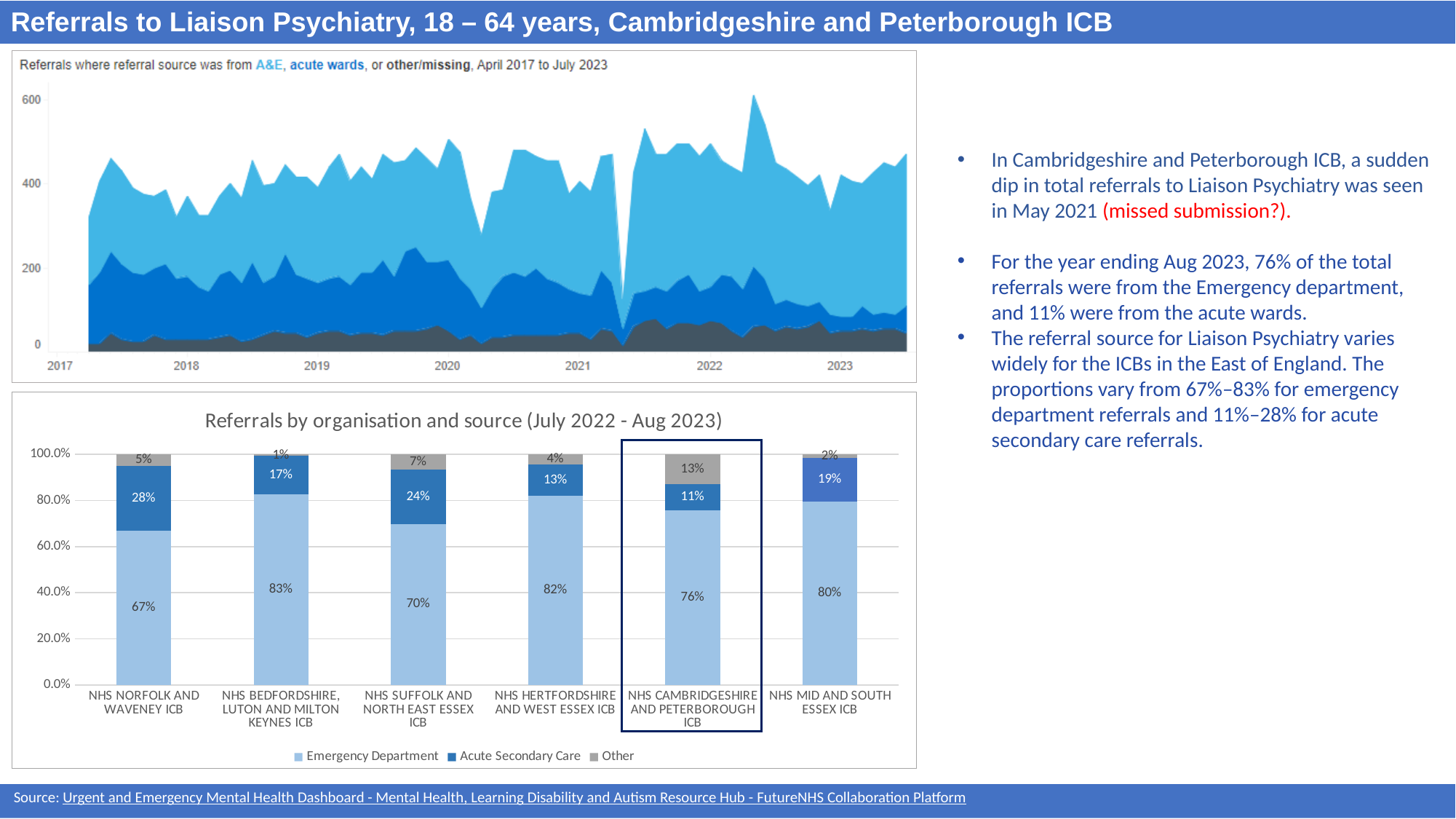
In the 'Referrals by organisation and source' chart, what is the 'Other' share for NHS Norfolk and Waveney ICB? 5% How many series does the legend of the 'Referrals by organisation and source' chart list? 3 How many organisations are shown in the 'Referrals by organisation and source' chart? 6 In the 'Referrals by organisation and source' chart, which organisation has the highest Emergency Department share? NHS Bedfordshire, Luton and Milton Keynes ICB In the 'Referrals by organisation and source' chart, what is the Acute Secondary Care share for NHS Suffolk and North East Essex ICB? 24% In the top chart, is the total referrals value at the sudden dip in 2021 greater or less than 200? less In the 'Referrals by organisation and source' chart, what is the difference between the Acute Secondary Care shares of NHS Norfolk and Waveney ICB and NHS Cambridgeshire and Peterborough ICB? 17% What type of chart is the 'Referrals by organisation and source' chart? Stacked bar chart In the 'Referrals by organisation and source' chart, which has the larger 'Other' share: NHS Cambridgeshire and Peterborough ICB or NHS Hertfordshire and West Essex ICB? NHS Cambridgeshire and Peterborough ICB In the 'Referrals by organisation and source' chart, which organisation has the lowest Emergency Department share? NHS Norfolk and Waveney ICB In the 'Referrals by organisation and source' chart, what percentage of referrals for NHS Cambridgeshire and Peterborough ICB came from the Emergency Department? 76% What type of chart is the top chart showing referrals from April 2017 to July 2023? Stacked area chart